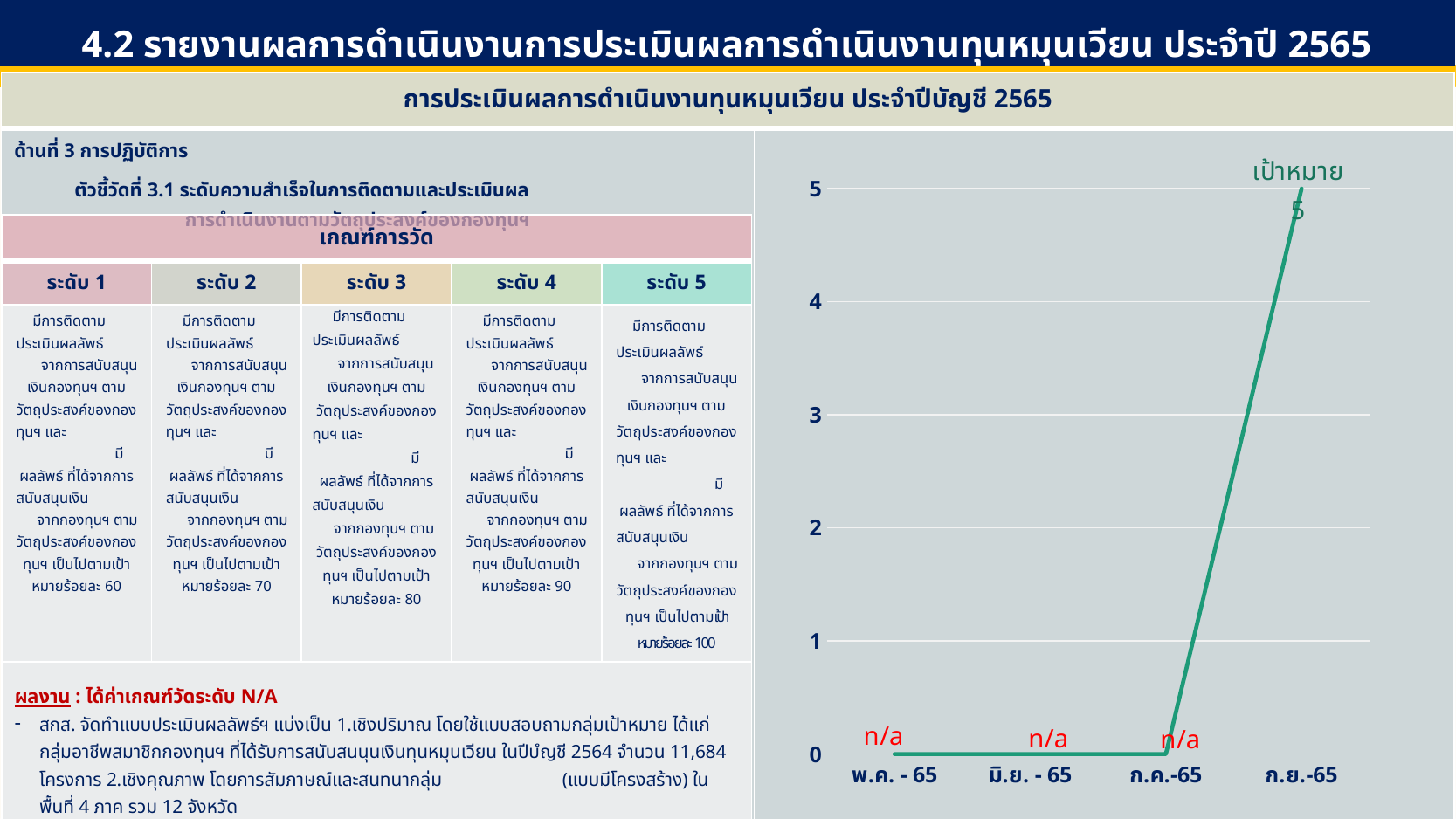
What is the highest value shown on the y axis of the chart? 5 Does the line on the chart rise or fall between ก.ค.-65 and ก.ย.-65? rise How many categories on the chart are labelled n/a? 3 What is the data label shown for ก.ค.-65 on the chart? n/a What is the data label shown for พ.ค. - 65 on the chart? n/a How many categories are shown on the x axis of the chart? 4 What label is written above the point for ก.ย.-65 on the chart? เป้าหมาย What is the data label shown for ก.ย.-65 on the chart? 5 Which category on the chart has the highest plotted value? ก.ย.-65 What is the data label shown for มิ.ย. - 65 on the chart? n/a Is the value for ก.ย.-65 greater or less than 4? greater What kind of chart is shown on the right side of the slide? line chart